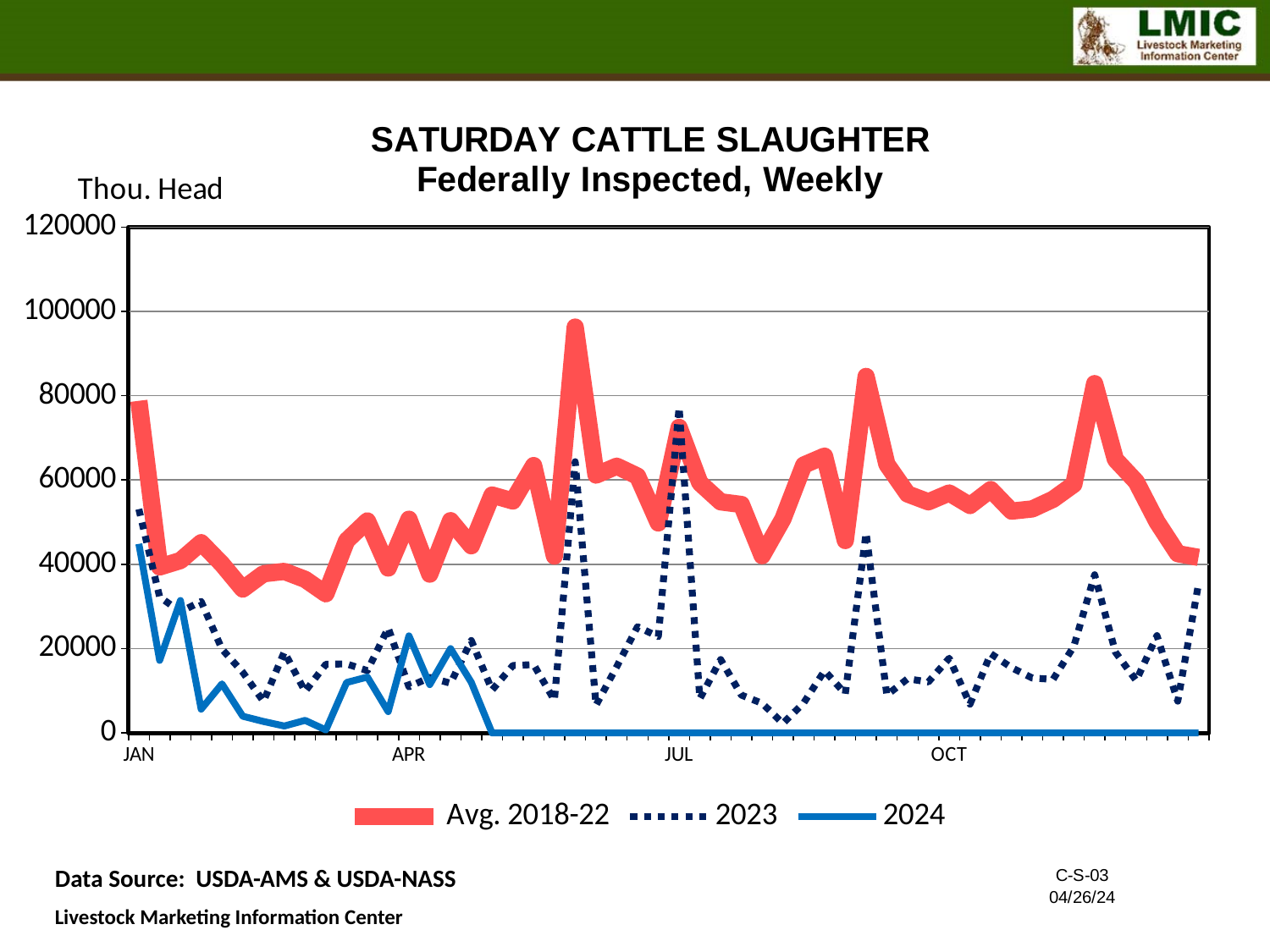
Is the peak value of the 2023 series near JUL greater or less than 60000? greater How many series does the legend list? 3 What kind of chart is shown on the slide? line chart How many month labels are shown on the x axis? 4 Does the 2024 series generally rise or fall from JAN to APR? fall What unit is shown on the y-axis label? Thou. Head Is the peak value of the Avg. 2018-22 series greater or less than 100000? less Is the peak value of the Avg. 2018-22 series greater or less than 80000? greater Which series has the highest value at JAN? Avg. 2018-22 What is the title of the chart? SATURDAY CATTLE SLAUGHTER Federally Inspected, Weekly Which series reaches the highest value on the chart? Avg. 2018-22